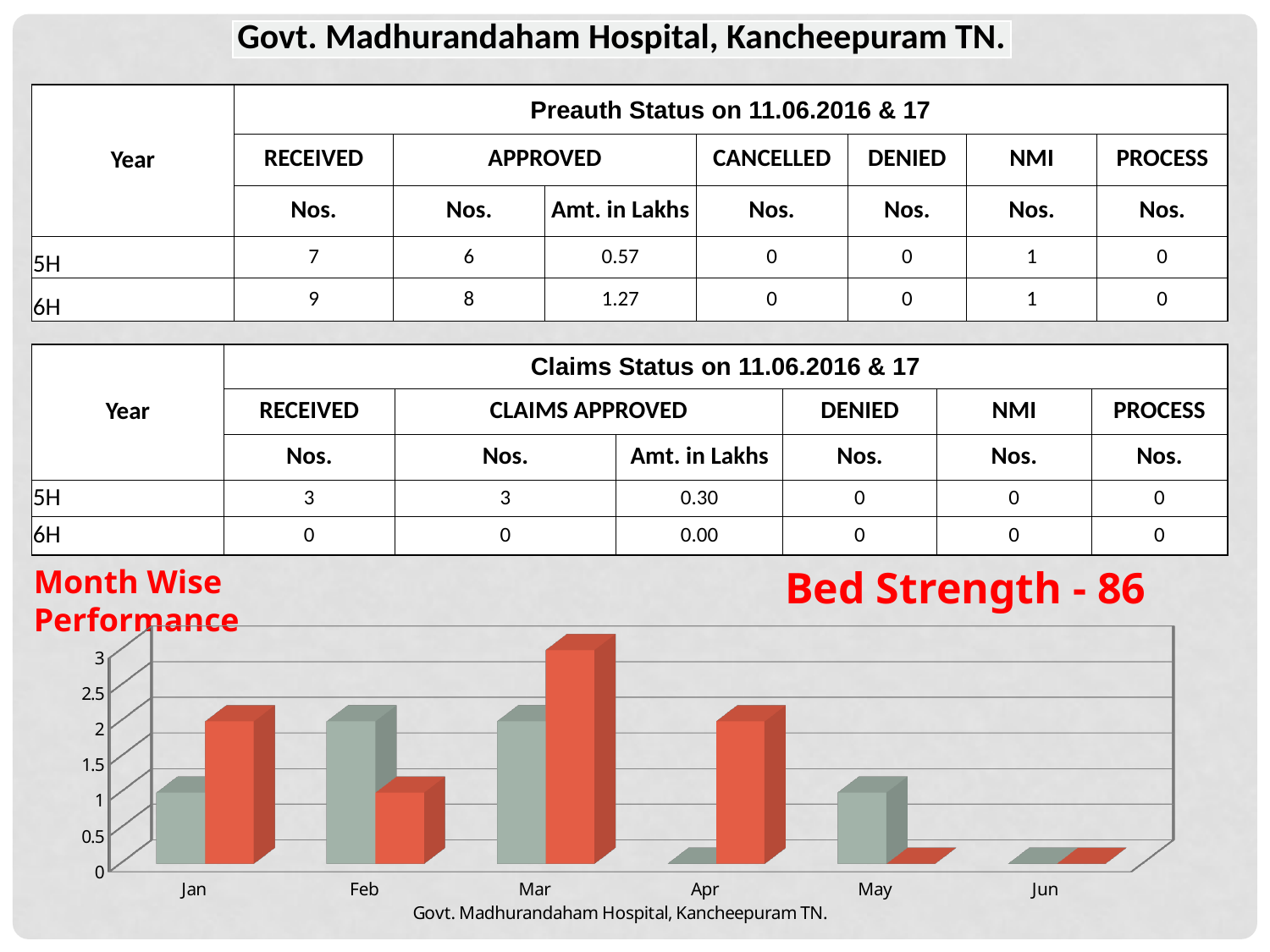
What kind of chart is shown at the bottom of the slide? bar chart What is the title printed beneath the chart? Govt. Madhurandaham Hospital, Kancheepuram TN. How many months are shown on the x axis of the chart? 6 In which month is the red bar the tallest? Mar Is the grey bar for May greater or less than 1.5? less In Jan, which bar is taller, the grey bar or the red bar? the red bar Do the red bars rise or fall from Mar to Jun? fall Is the red bar for Mar greater or less than 2.5? greater Is the red bar for Apr greater or less than 1.5? greater In Feb, which bar is taller, the grey bar or the red bar? the grey bar